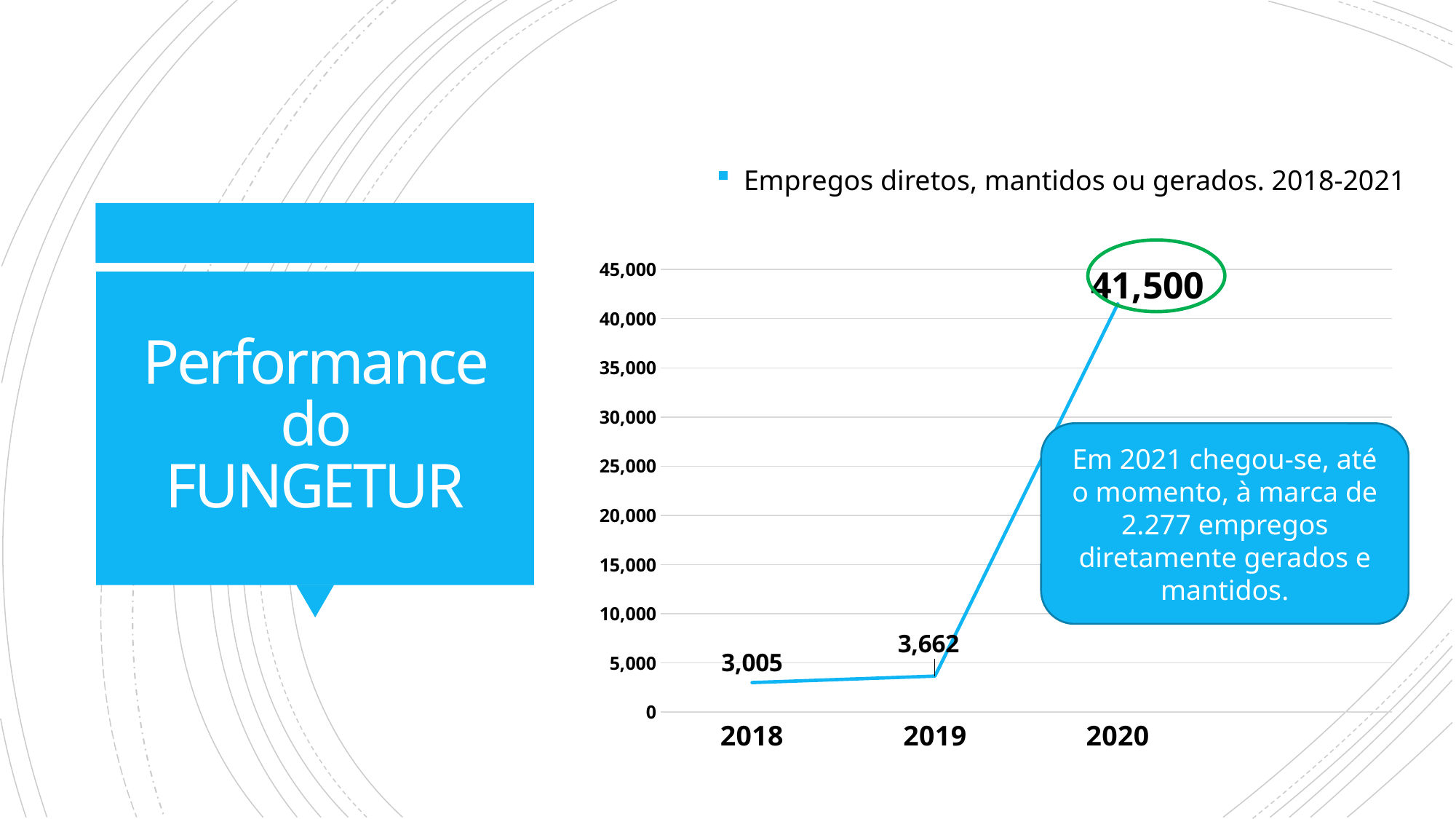
Do the values rise or fall from 2018 to 2020? rise Which year has the highest value? 2020 How many years are plotted on the chart? 3 What is the difference between the values for 2019 and 2018? 657 What is the difference between the values for 2020 and 2019? 37,838 What is the value for 2019? 3,662 What kind of chart is shown on the slide? line chart What is the value for 2018? 3,005 Which is larger, the value for 2018 or the value for 2019? 2019 What is the value for 2020? 41,500 Which year has the lowest value? 2018 Is the value for 2020 greater or less than 40,000? greater